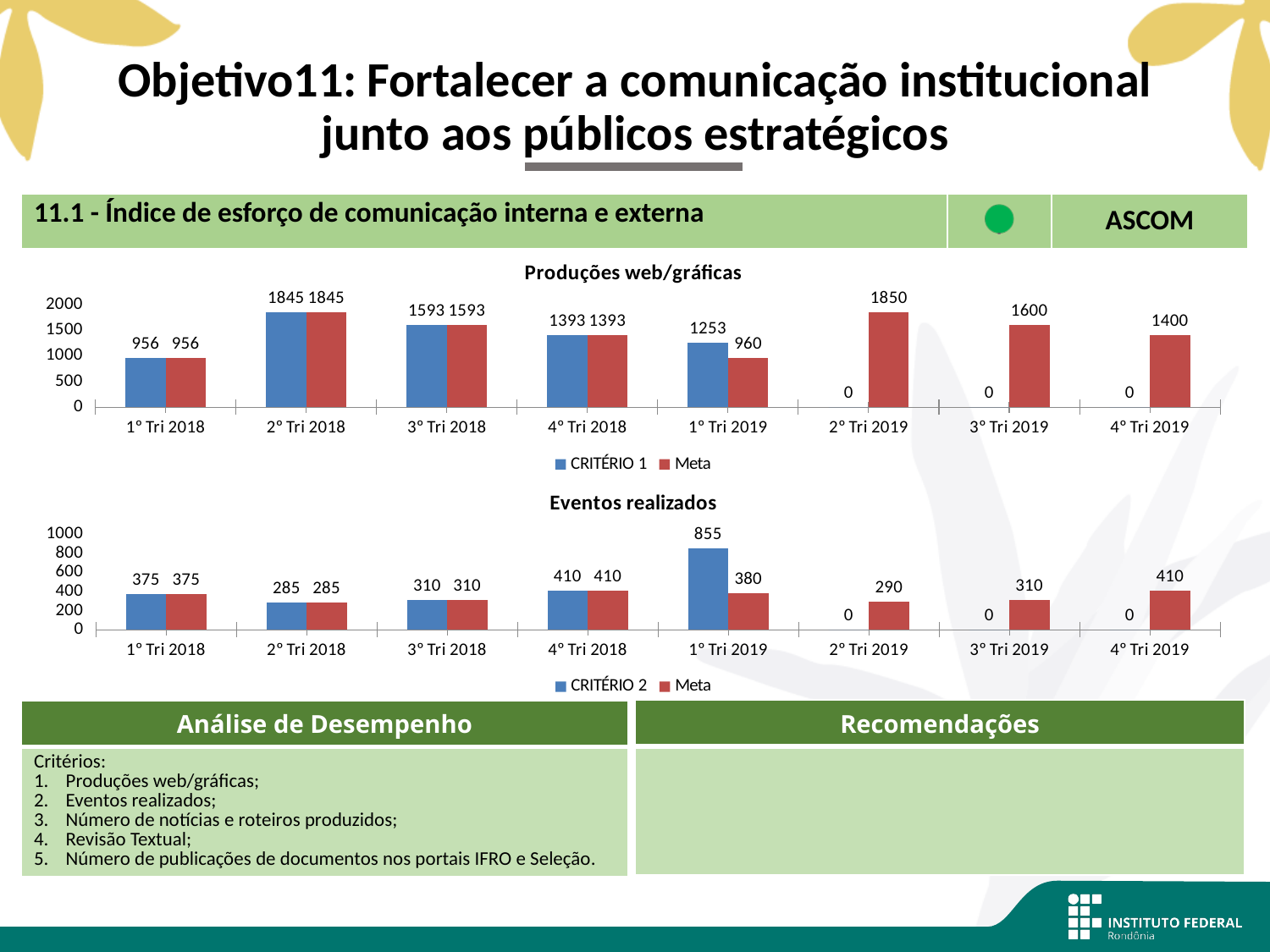
In the 'Eventos realizados' chart, what is the difference between CRITÉRIO 2 and Meta for 1° Tri 2019? 475 What kind of chart is the 'Produções web/gráficas' chart? Bar chart How many quarters are shown on the x axis of the 'Eventos realizados' chart? 8 In the 'Produções web/gráficas' chart, which quarter has the highest Meta value? 2° Tri 2019 In the 'Eventos realizados' chart, is CRITÉRIO 2 or Meta larger for 1° Tri 2019? CRITÉRIO 2 In the 'Produções web/gráficas' chart, how many series does the legend list? 2 In the 'Eventos realizados' chart, which quarter has the lowest Meta value? 2° Tri 2018 In the 'Produções web/gráficas' chart, what is the CRITÉRIO 1 value for 2° Tri 2018? 1845 In the 'Produções web/gráficas' chart, what is the difference between CRITÉRIO 1 and Meta for 1° Tri 2019? 293 In the 'Produções web/gráficas' chart, what is the Meta value for 1° Tri 2019? 960 In the 'Produções web/gráficas' chart, what is the CRITÉRIO 1 value for 3° Tri 2019? 0 In the 'Eventos realizados' chart, what is the CRITÉRIO 2 value for 1° Tri 2019? 855